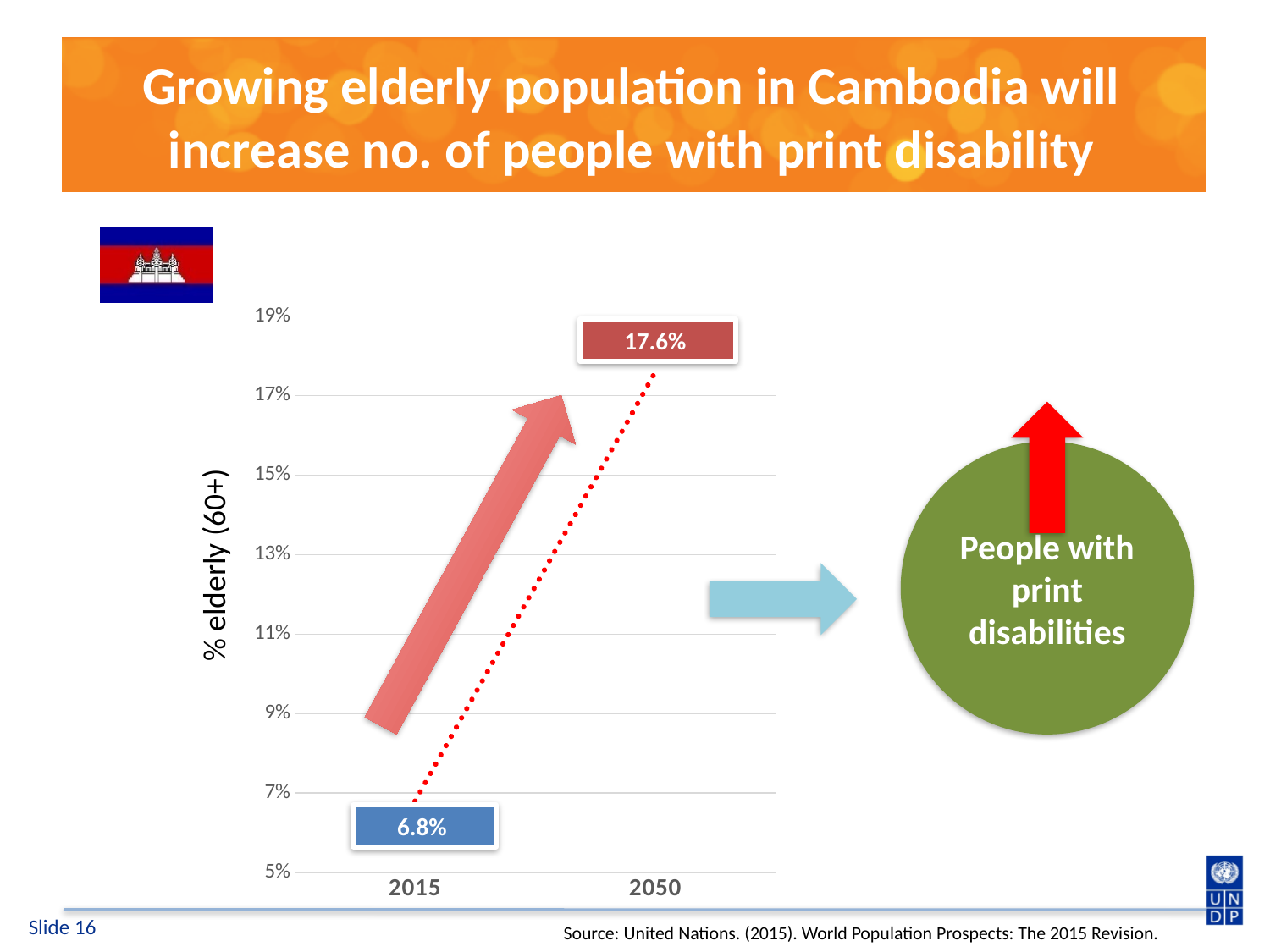
What is the value for 2050? 17.6% What is the highest value shown on the vertical axis? 19% Is the value for 2050 greater or less than 15%? greater What is the difference between the 2050 value and the 2015 value? 10.8% Which year has the lowest value? 2015 Do the values rise or fall from 2015 to 2050? rise Is the value for 2015 greater or less than 7%? less How many years are plotted on the chart? 2 What is the label of the vertical axis? % elderly (60+) Which year has the higher value, 2015 or 2050? 2050 What is the value for 2015? 6.8%